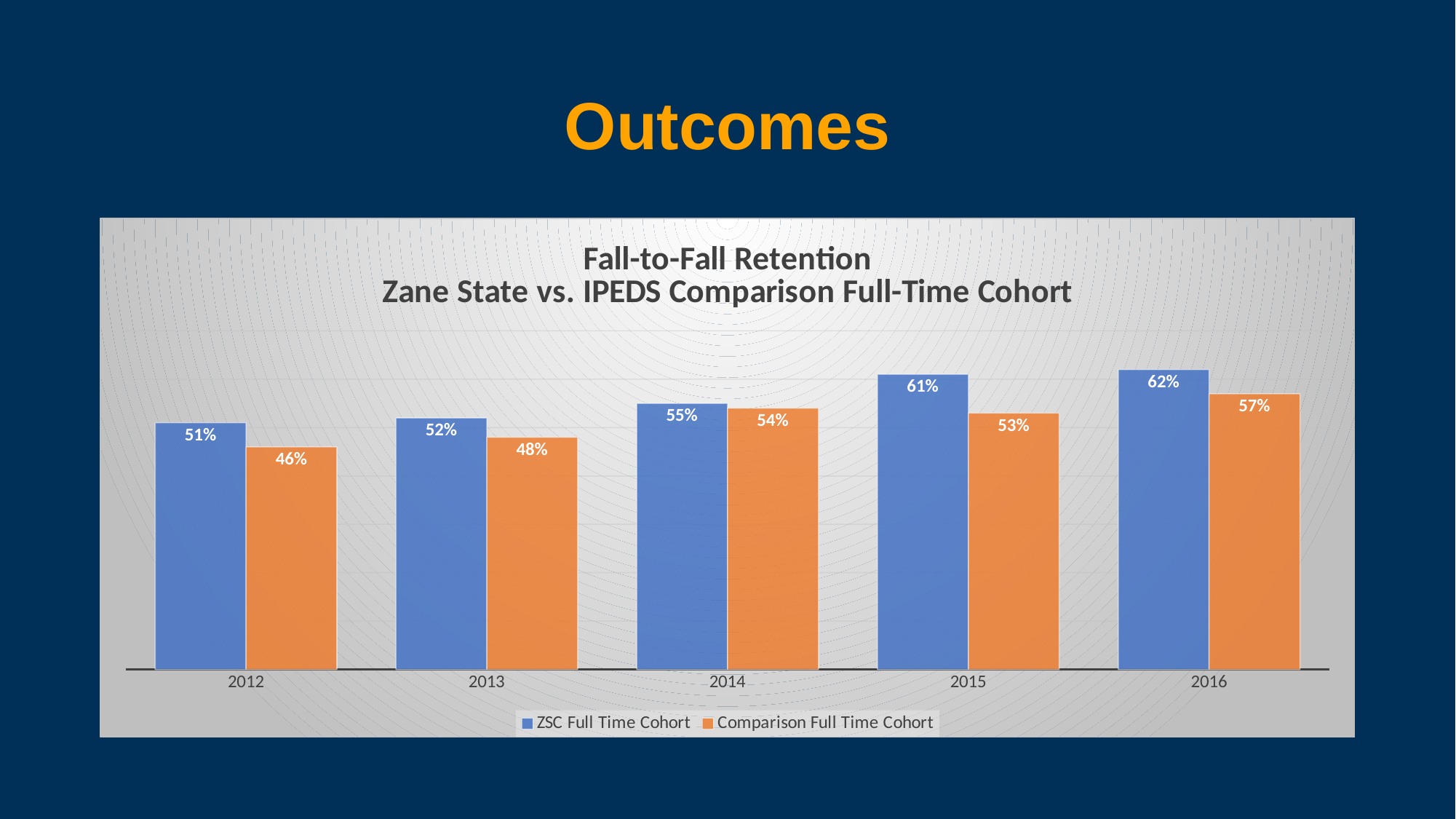
What is the Comparison Full Time Cohort value for 2016? 57% In which year is the Comparison Full Time Cohort retention lowest? 2012 Does the ZSC Full Time Cohort retention rise or fall from 2012 to 2016? Rise How many series does the legend list? 2 In which year is the ZSC Full Time Cohort retention highest? 2016 What is the Comparison Full Time Cohort retention value for 2012? 46% Which is larger in 2013: the ZSC Full Time Cohort or the Comparison Full Time Cohort? ZSC Full Time Cohort What is the ZSC Full Time Cohort retention value for 2014? 55% How many years are shown on the x axis? 5 What kind of chart is shown on the slide? Bar chart What is the difference between the ZSC Full Time Cohort and the Comparison Full Time Cohort in 2015? 8% What colour are the bars for the Comparison Full Time Cohort? Orange